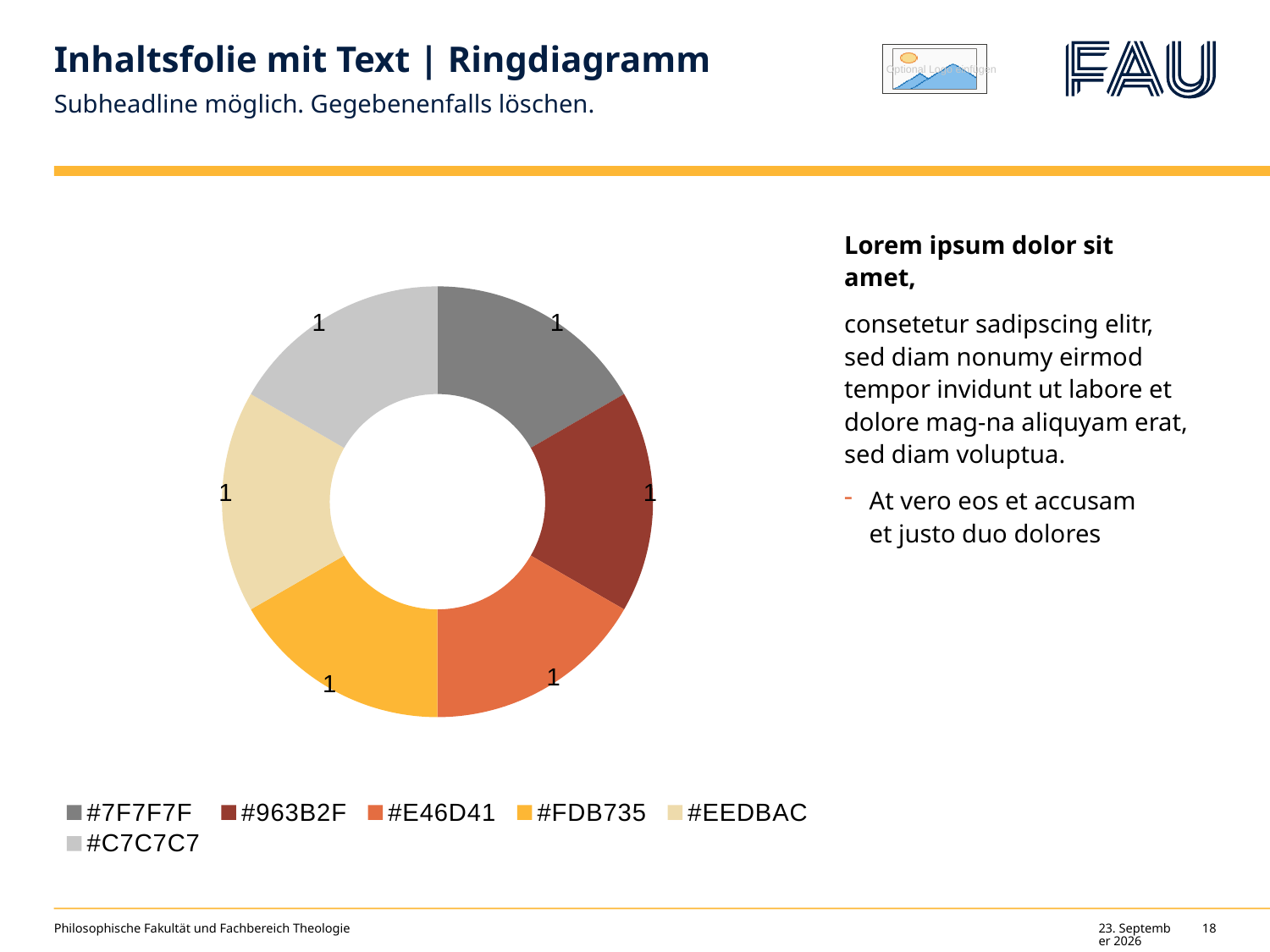
What kind of chart is shown on the slide? Doughnut chart How many entries does the legend of the doughnut chart list? 6 What is the value of the #FDB735 slice in the doughnut chart? 1 Is the value of the #EEDBAC slice larger than, smaller than, or equal to the value of the #7F7F7F slice? Equal How many slices does the doughnut chart have? 6 Which legend entry is shown in the darkest red colour? #963B2F What is the total of all slice values in the doughnut chart? 6 What is the value of the #7F7F7F slice in the doughnut chart? 1 Which legend entry is listed first in the doughnut chart's legend? #7F7F7F What is the value of the #C7C7C7 slice in the doughnut chart? 1 What is the difference between the values of the #963B2F and #E46D41 slices? 0 What fraction of the doughnut chart does the #963B2F slice represent? 1/6